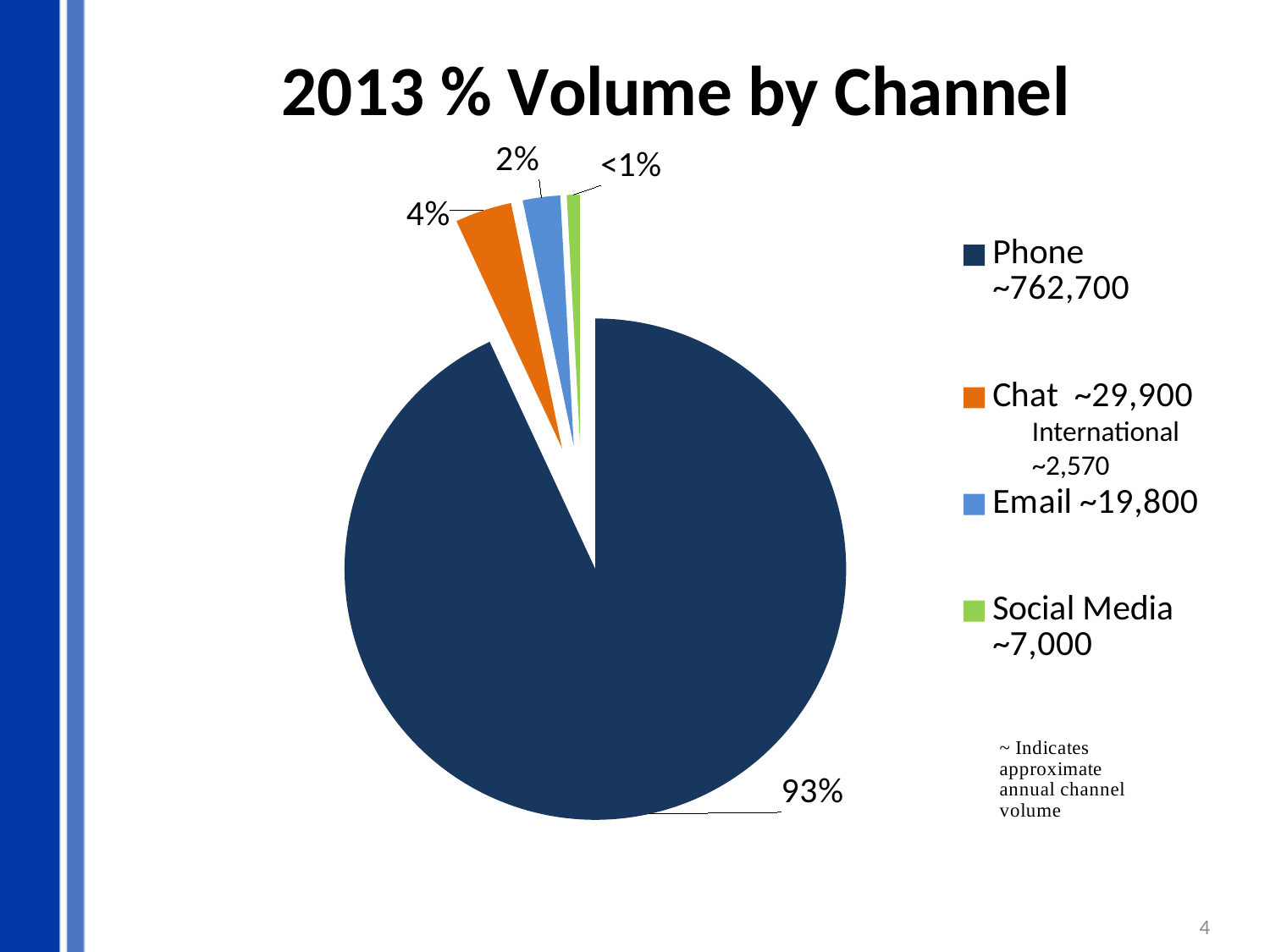
What share of the pie does Social Media account for? <1% What share of the pie does Email account for? 2% How many slices does the pie chart have? 4 Which has a larger share of the pie, Chat or Email? Chat What share of the pie does Phone account for? 93% How many entries does the legend list? 4 Which channel has the smallest slice of the pie? Social Media What is the title of the chart? 2013 % Volume by Channel Which channel has the largest slice of the pie? Phone What is the difference in percentage points between the Phone share and the Chat share? 89% What kind of chart is shown on the slide? pie chart